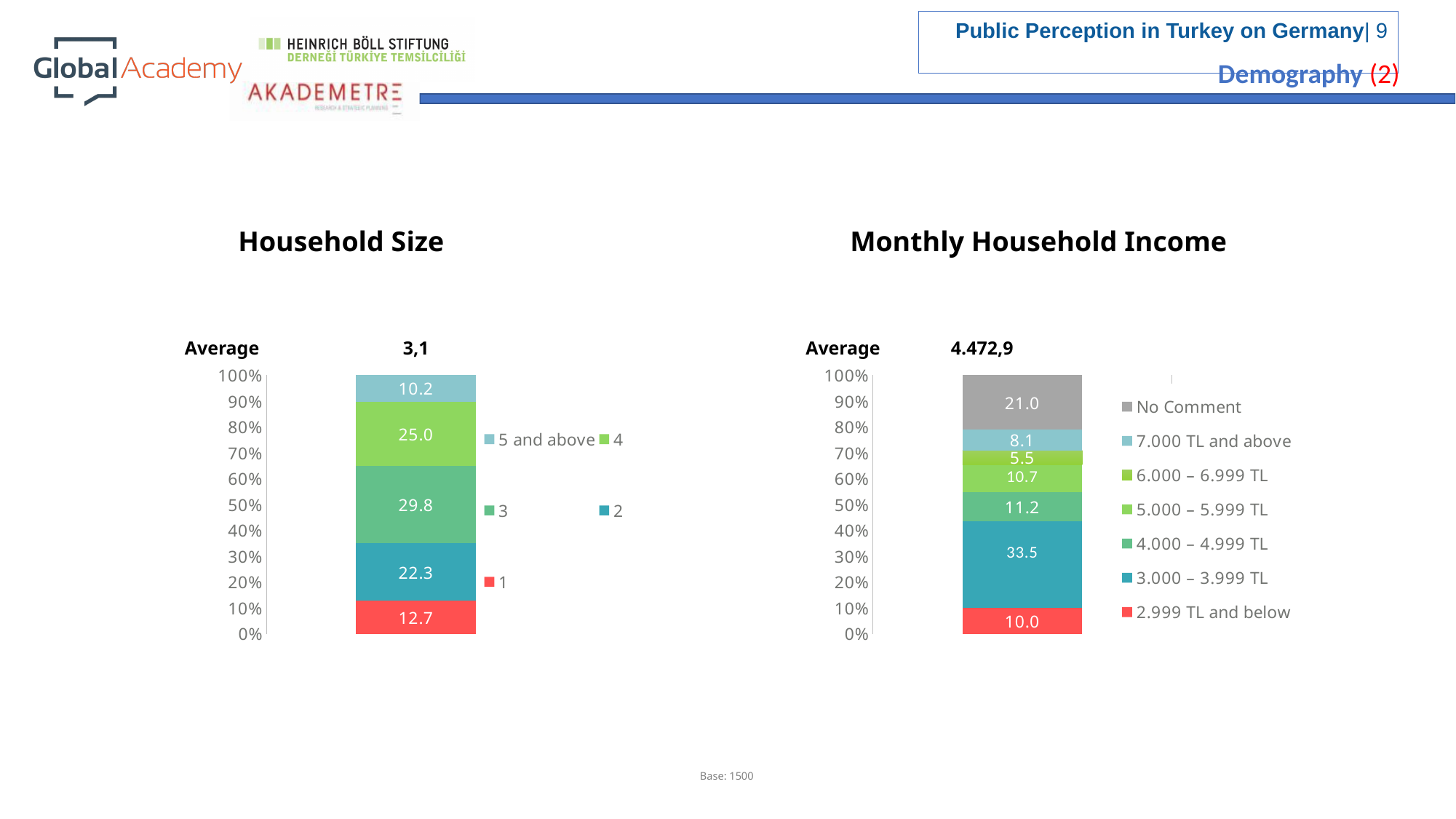
In the Monthly Household Income chart, which is larger: 7.000 TL and above or 2.999 TL and below? 2.999 TL and below In the Monthly Household Income chart, what is the value for 3.000 – 3.999 TL? 33.5 In the Household Size chart, which segment has the largest value? 3 In the Household Size chart, which segment has the smallest value? 5 and above How many series does the legend of the Household Size chart list? 5 In the Household Size chart, what is the value for the segment labelled 3? 29.8 How many series does the legend of the Monthly Household Income chart list? 7 What kind of chart is the Monthly Household Income chart? Stacked bar chart In the Monthly Household Income chart, what is the value for No Comment? 21.0 In the Household Size chart, what is the value for the segment labelled 5 and above? 10.2 In the Household Size chart, what is the difference between the values for segments 4 and 1? 12.3 In the Monthly Household Income chart, which income band has the smallest value? 6.000 – 6.999 TL